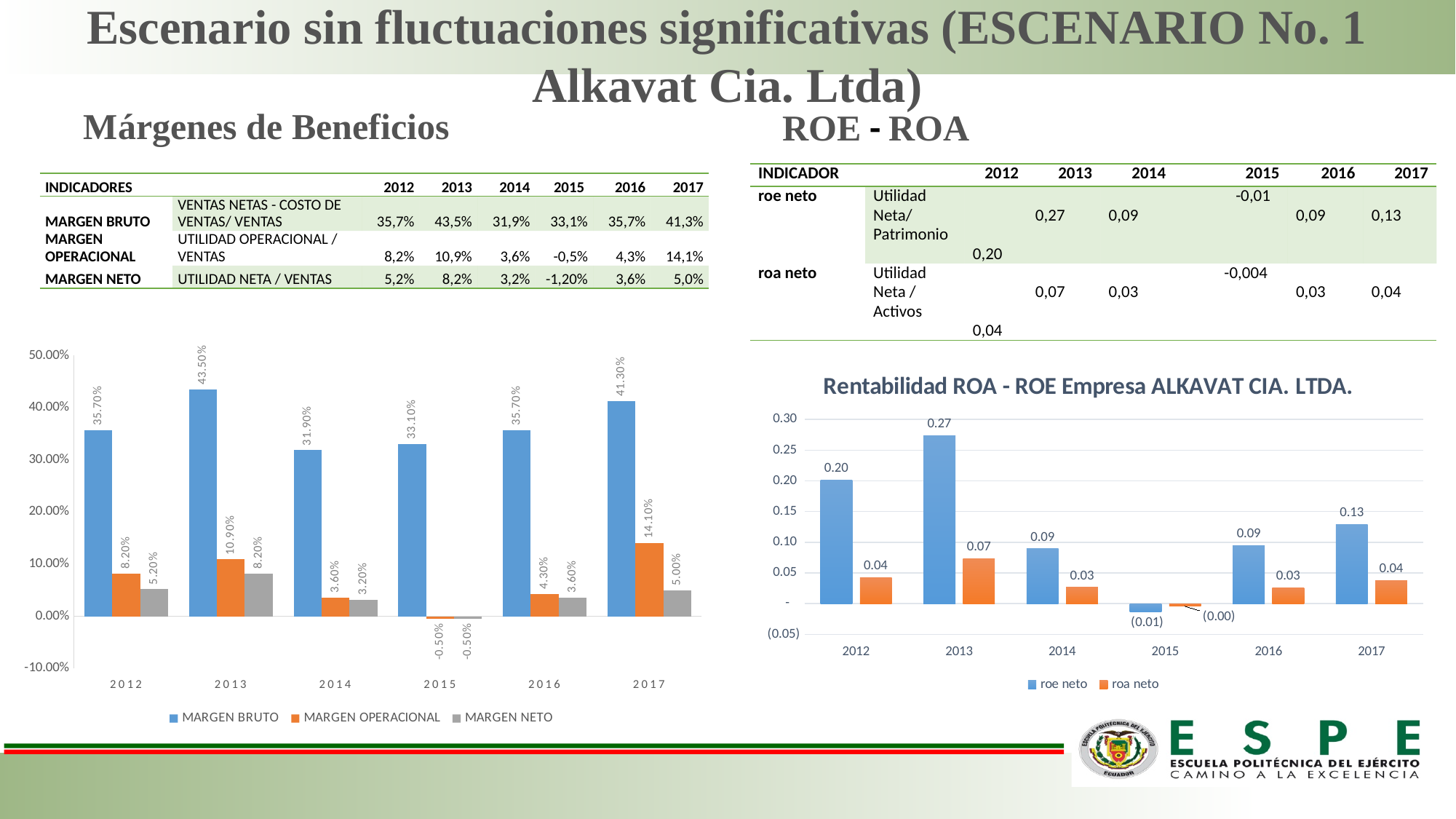
In the left chart (Márgenes de Beneficios), how many years are shown on the x axis? 6 In the chart titled 'Rentabilidad ROA - ROE Empresa ALKAVAT CIA. LTDA.', which is larger: roe neto in 2012 or roe neto in 2017? roe neto in 2012 In the chart titled 'Rentabilidad ROA - ROE Empresa ALKAVAT CIA. LTDA.', what is the value of roa neto for 2016? 0.03 What kind of chart is the chart titled 'Rentabilidad ROA - ROE Empresa ALKAVAT CIA. LTDA.'? Bar chart In the left chart (Márgenes de Beneficios), what is the difference between MARGEN BRUTO in 2017 and MARGEN BRUTO in 2014? 9.40% In the left chart (Márgenes de Beneficios), which year has the highest MARGEN BRUTO? 2013 In the chart titled 'Rentabilidad ROA - ROE Empresa ALKAVAT CIA. LTDA.', what is the value of roe neto for 2013? 0.27 In the chart titled 'Rentabilidad ROA - ROE Empresa ALKAVAT CIA. LTDA.', what is the difference between roe neto and roa neto in 2013? 0.20 In the left chart (Márgenes de Beneficios), which year has the lowest MARGEN NETO? 2015 In the left chart (Márgenes de Beneficios), how many series does the legend list? 3 In the left chart (Márgenes de Beneficios), what is the value of MARGEN OPERACIONAL for 2017? 14.10% In the left chart (Márgenes de Beneficios), what is the value of MARGEN BRUTO for 2013? 43.50%